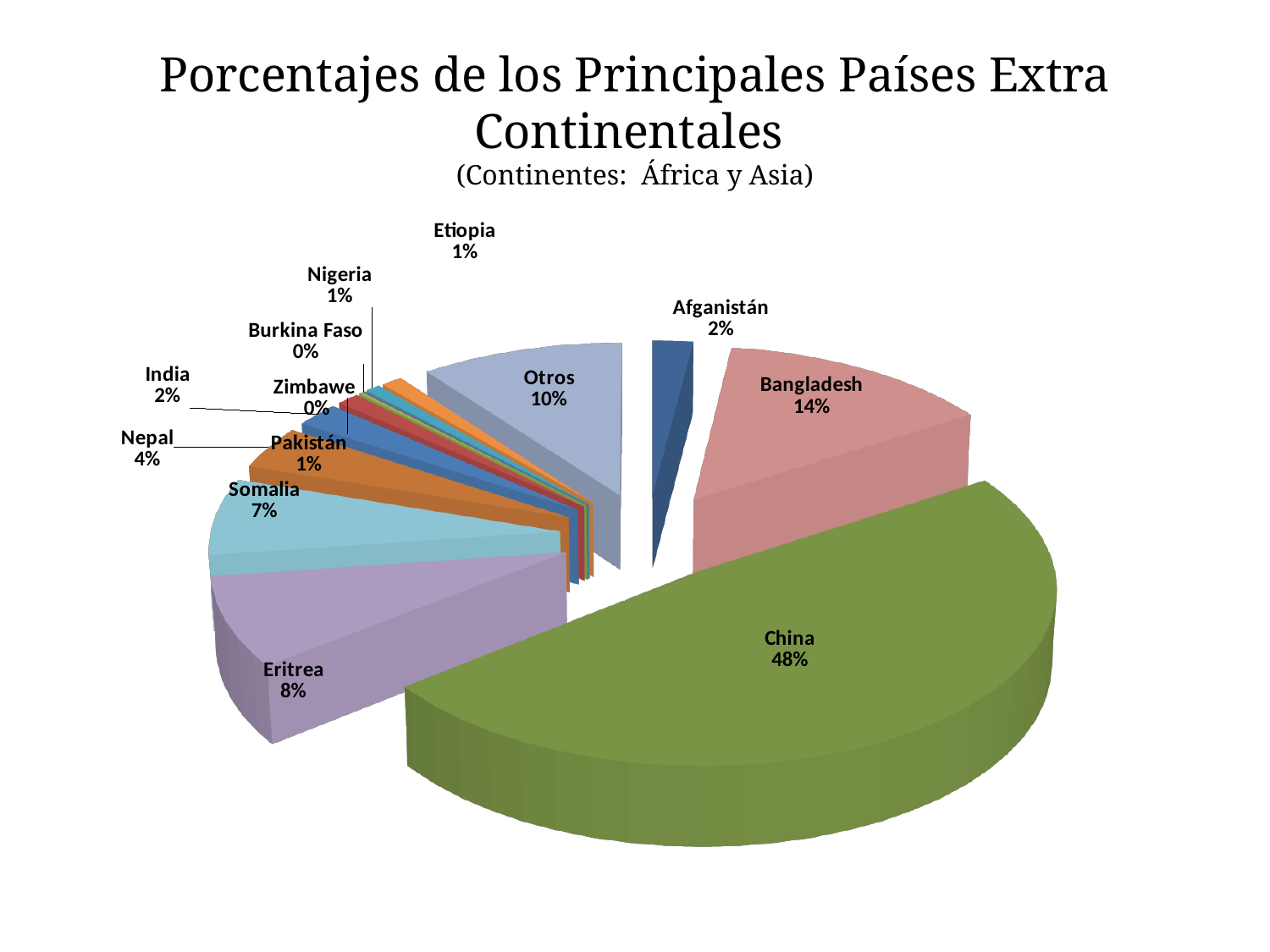
Which country has the largest slice of the pie chart? China What is the subtitle shown under the chart title? (Continentes: África y Asia) What percentage does China account for in the pie chart? 48% What percentage is shown for Bangladesh? 14% Which slice is larger, Bangladesh or Otros? Bangladesh How many slices are labelled in the pie chart? 13 What is the difference in percentage points between Otros and Eritrea? 2 What is the difference in percentage points between China and Bangladesh? 34 What type of chart is shown on the slide? Pie chart Which slice is larger, Eritrea or Somalia? Eritrea What percentage is labelled for Nepal? 4% What is the percentage for Somalia? 7%